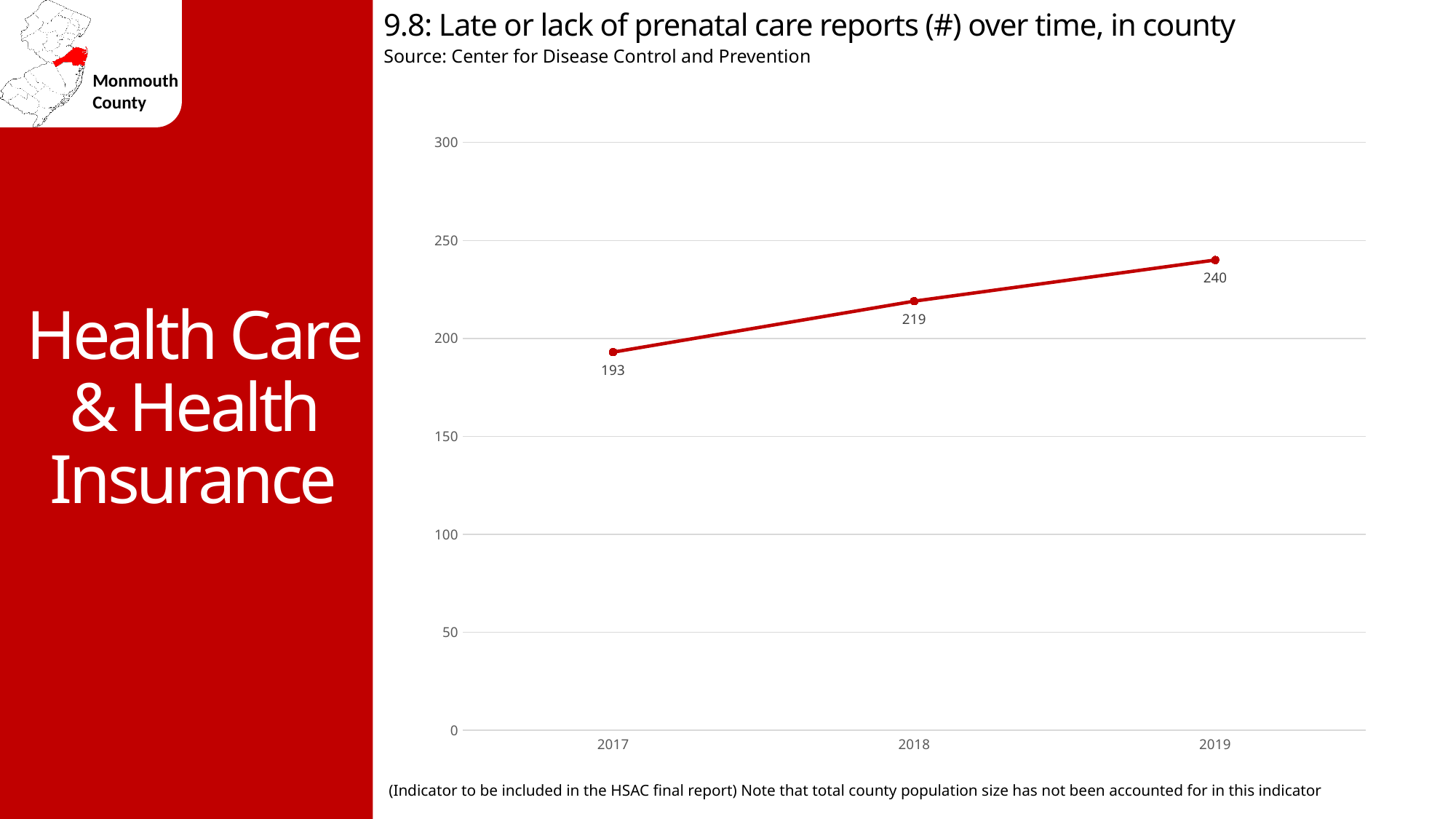
Do the values rise or fall from 2017 to 2019? rise Which year has more late or lack of prenatal care reports, 2018 or 2019? 2019 What is the difference between the number of reports in 2019 and 2017? 47 What kind of chart is shown on the slide? line chart What is the number of late or lack of prenatal care reports in 2018? 219 Which year has the lowest number of late or lack of prenatal care reports? 2017 Which year has the highest number of late or lack of prenatal care reports? 2019 Is the value for 2017 greater or less than 200? less What is the number of late or lack of prenatal care reports in 2019? 240 What is the number of late or lack of prenatal care reports in 2017? 193 How many years are plotted on the chart? 3 What is the difference between the number of reports in 2018 and 2017? 26